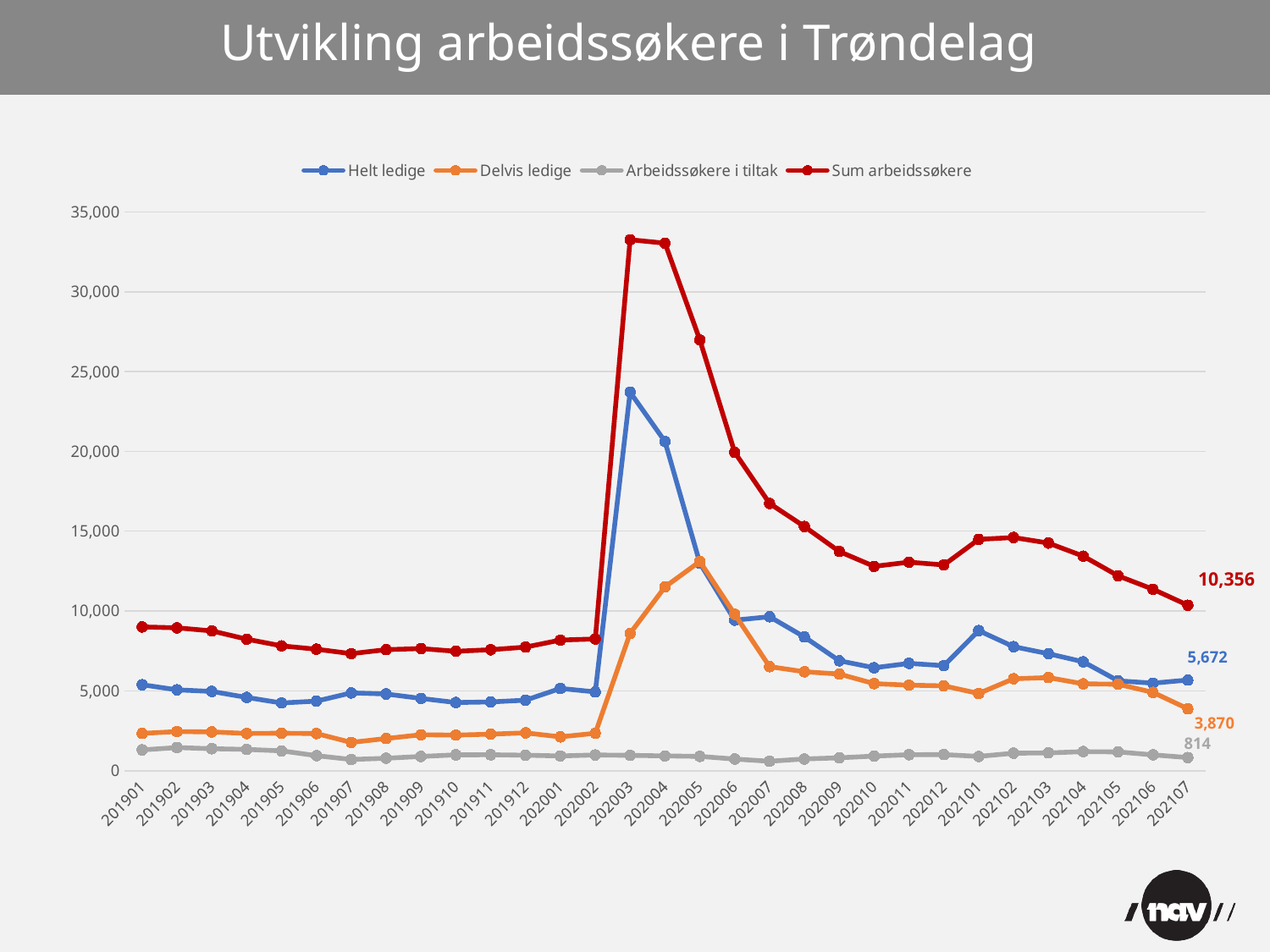
What kind of chart is shown on the slide? Line chart What is the title of the chart? Utvikling arbeidssøkere i Trøndelag What is the value of Sum arbeidssøkere at 202107? 10,356 How many series does the legend list? 4 What is the value of Helt ledige at 202107? 5,672 What is the difference between Helt ledige and Delvis ledige at 202107? 1,802 How many periods are shown on the x axis? 31 Does Sum arbeidssøkere rise or fall from 202102 to 202107? Fall What is the value of Delvis ledige at 202107? 3,870 Is the value for Sum arbeidssøkere at 202003 greater or less than 30,000? greater What is the value of Arbeidssøkere i tiltak at 202107? 814 Which series has the highest value at 202107? Sum arbeidssøkere